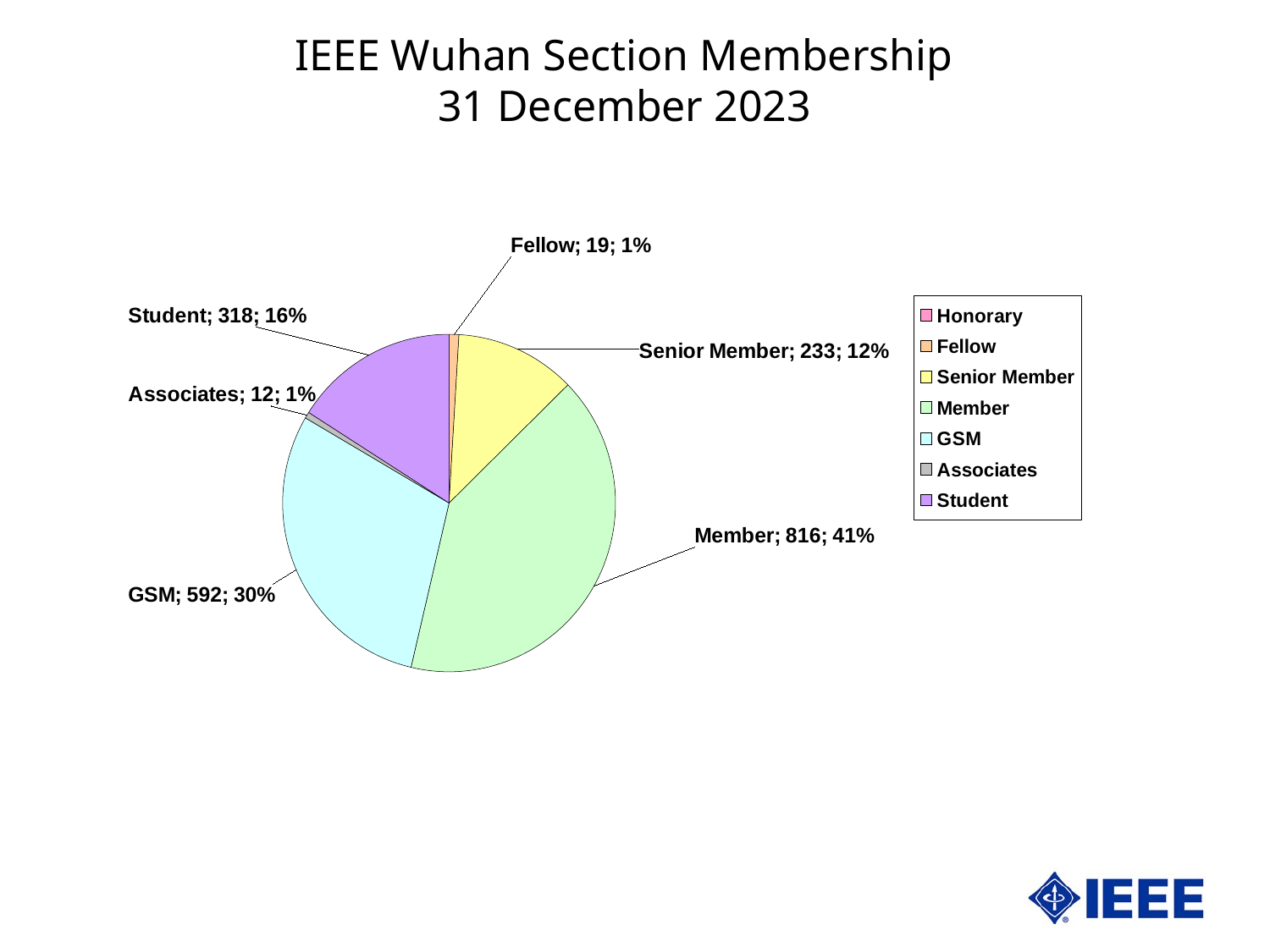
What is the difference in member count between Fellow and Associates? 7 Which has more members, GSM or Student? GSM How many members are in the Member category? 816 How many members are in the Student category? 318 What share of the pie does Senior Member represent? 12% What colour is the Member slice? light green What is the title of the chart? IEEE Wuhan Section Membership 31 December 2023 Which category has the largest slice of the pie? Member How many entries does the legend list? 7 What is the difference in member count between Member and GSM? 224 What kind of chart is shown on the slide? pie chart What percentage of the membership is GSM? 30%